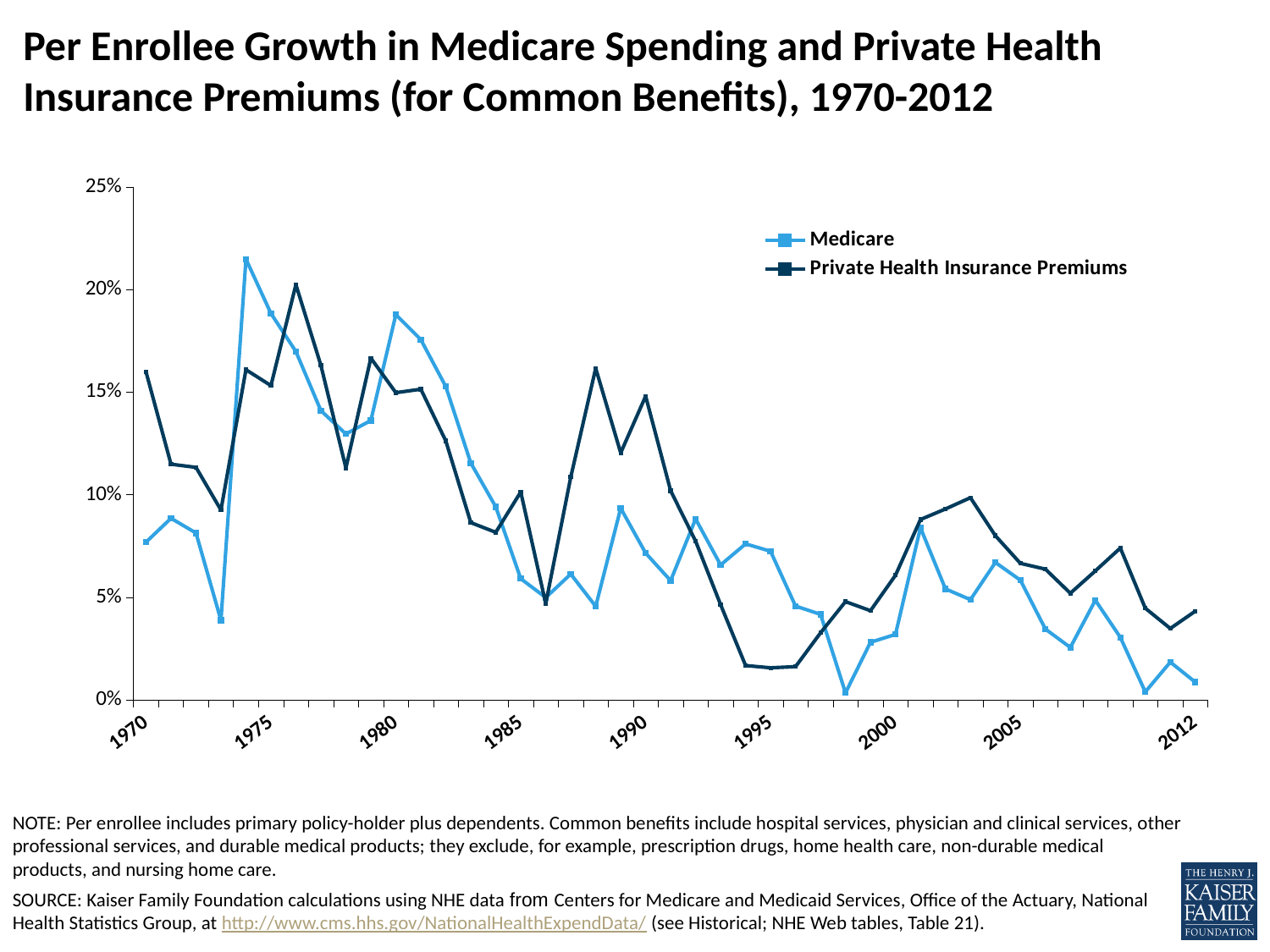
In which year does the Medicare series reach its highest value? 1974 In 1970, which series has the larger value, Medicare or Private Health Insurance Premiums? Private Health Insurance Premiums What are the two series named in the legend? Medicare; Private Health Insurance Premiums In 1995, which series has the larger value, Medicare or Private Health Insurance Premiums? Medicare Overall, do the growth rates for both series rise or fall between 1970 and 2012? fall Is the Medicare value for 1970 greater or less than 5%? greater In which year does the Private Health Insurance Premiums series reach its highest value? 1976 Is the Medicare value for 2012 greater or less than 5%? less Is the Private Health Insurance Premiums value for 1990 greater or less than 10%? greater What kind of chart is shown on the slide? line chart How many series does the legend list? 2